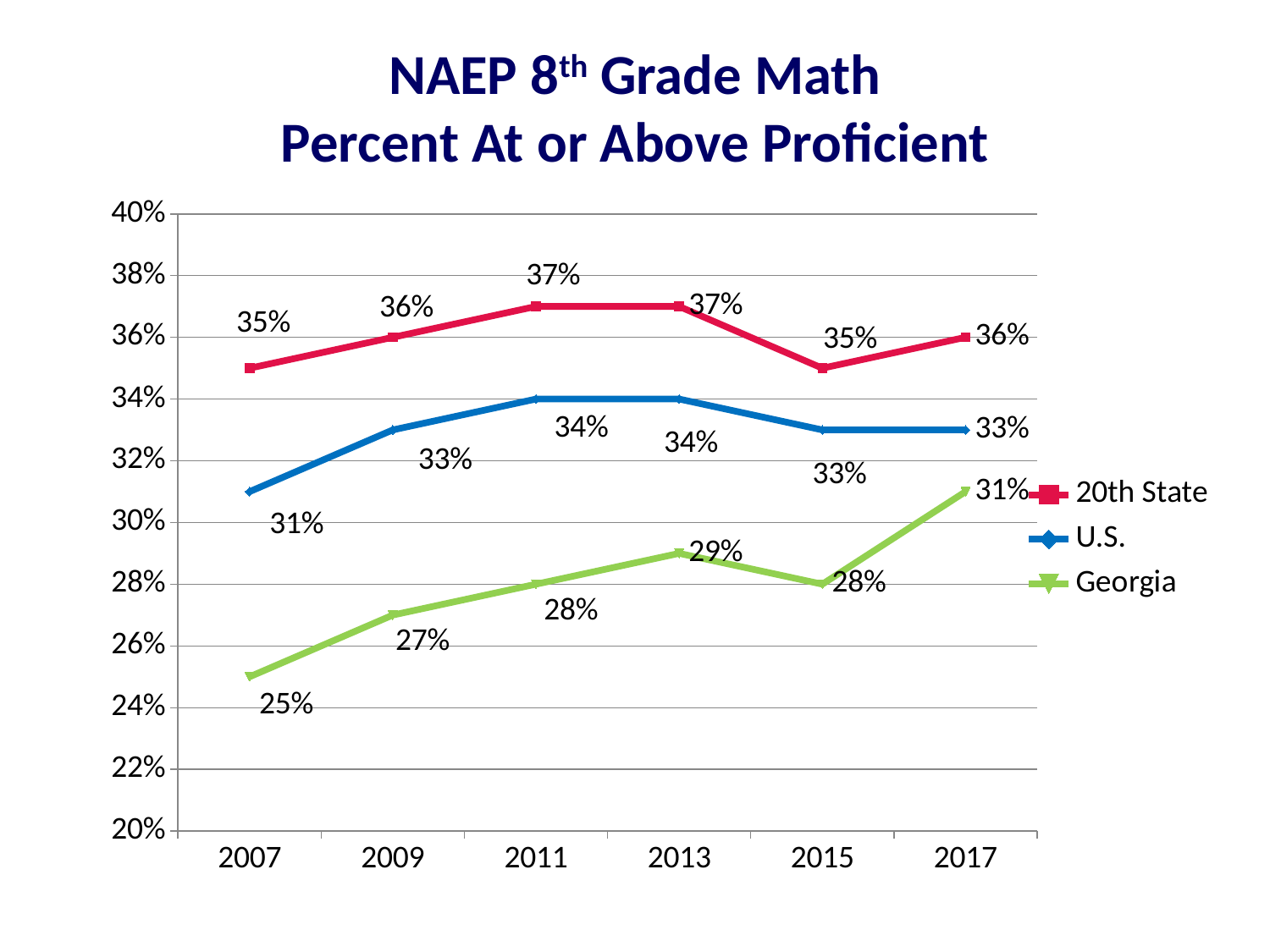
How many series does the legend list? 3 Does the Georgia value rise or fall from 2007 to 2013? rise What is the value for U.S. in 2015? 33% What is the value for the 20th State series in 2011? 37% In which year is the U.S. value lowest? 2007 What kind of chart is this? line chart What is the difference between the 20th State value and the Georgia value in 2017? 5% Is the Georgia value in 2009 greater or less than 30%? less Which is larger in 2013: the U.S. value or the Georgia value? U.S. What is the value for Georgia in 2007? 25% How many years are shown on the x axis? 6 In which year is the Georgia value highest? 2017